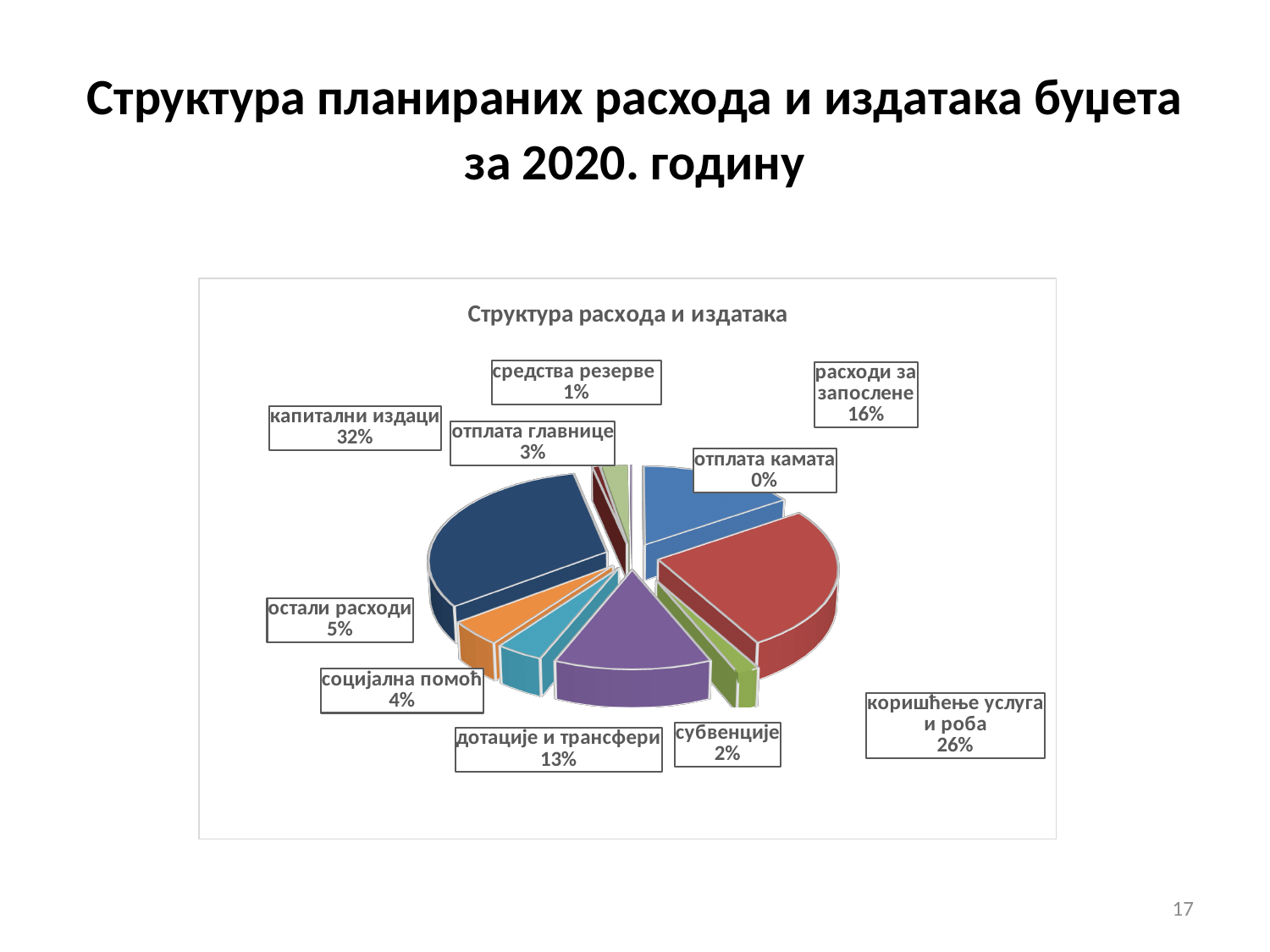
What share of the pie is коришћење услуга и роба? 26% What kind of chart is shown on the slide? Pie chart What is the value shown for расходи за запослене? 16% How many categories are shown in the pie chart? 10 What is the title of the chart? Структура расхода и издатака What is the difference between the shares of капитални издаци and коришћење услуга и роба? 6% What is the value shown for дотације и трансфери? 13% Which category has the smallest share of the pie? отплата камата What is the value shown for средства резерве? 1% Which category has the largest share of the pie? капитални издаци Which is larger, the share for социјална помоћ or the share for остали расходи? остали расходи What share of the pie is капитални издаци? 32%